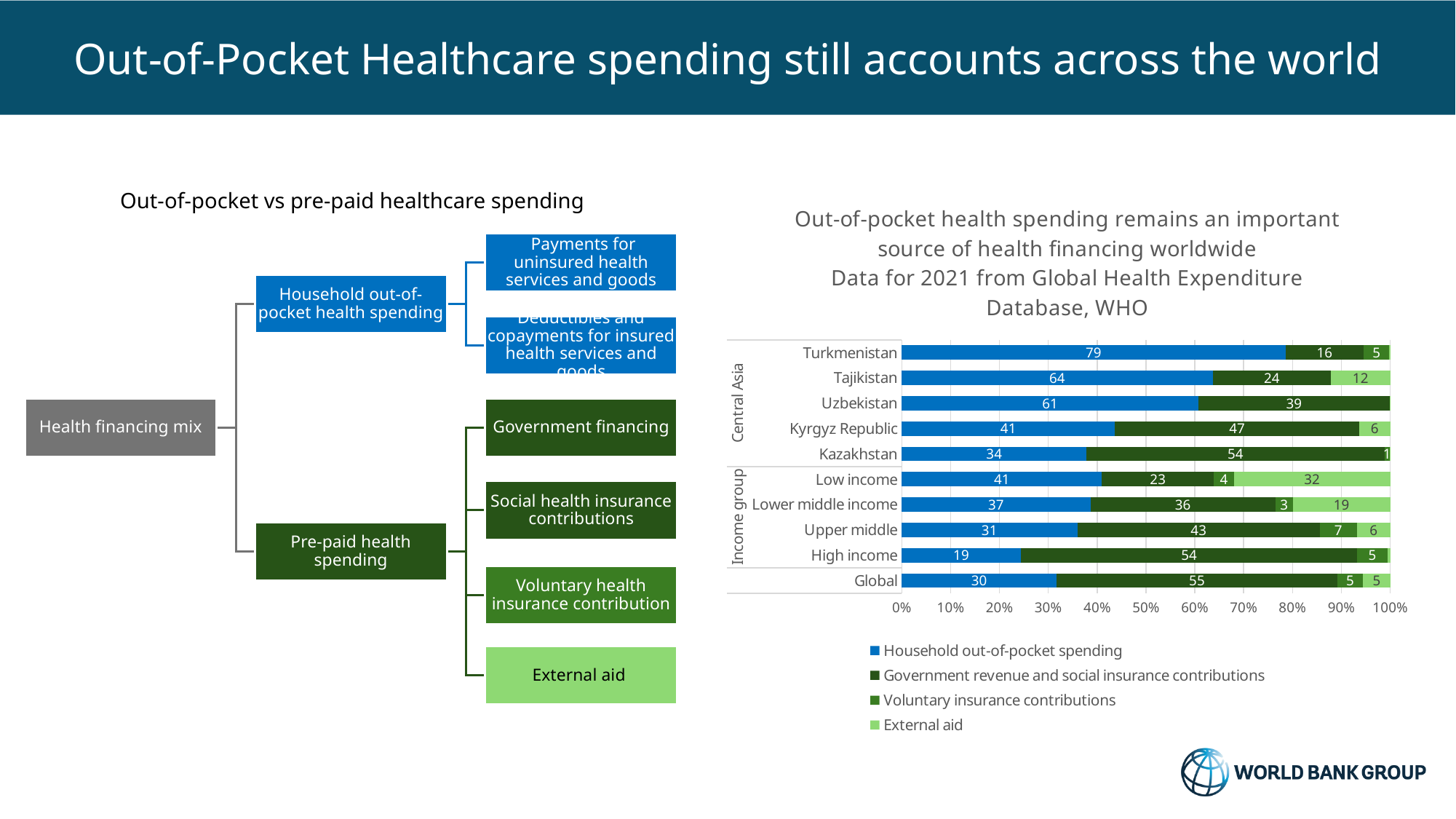
What is the external aid value for Low income? 32 What is the government revenue and social insurance contributions value for the Kyrgyz Republic? 47 What is the household out-of-pocket spending value for Turkmenistan? 79 Which category has the highest household out-of-pocket spending share? Turkmenistan Which has a larger household out-of-pocket spending value, Tajikistan or Uzbekistan? Tajikistan What is the government revenue and social insurance contributions value for Global? 55 What is the difference between the household out-of-pocket spending values for Turkmenistan and Kazakhstan? 45 How many series does the legend list? 4 How many categories (bars) are shown in the chart? 10 Which series is listed first in the chart legend? Household out-of-pocket spending Which category has the lowest household out-of-pocket spending share? High income What kind of chart is shown on the right of the slide? Stacked bar chart